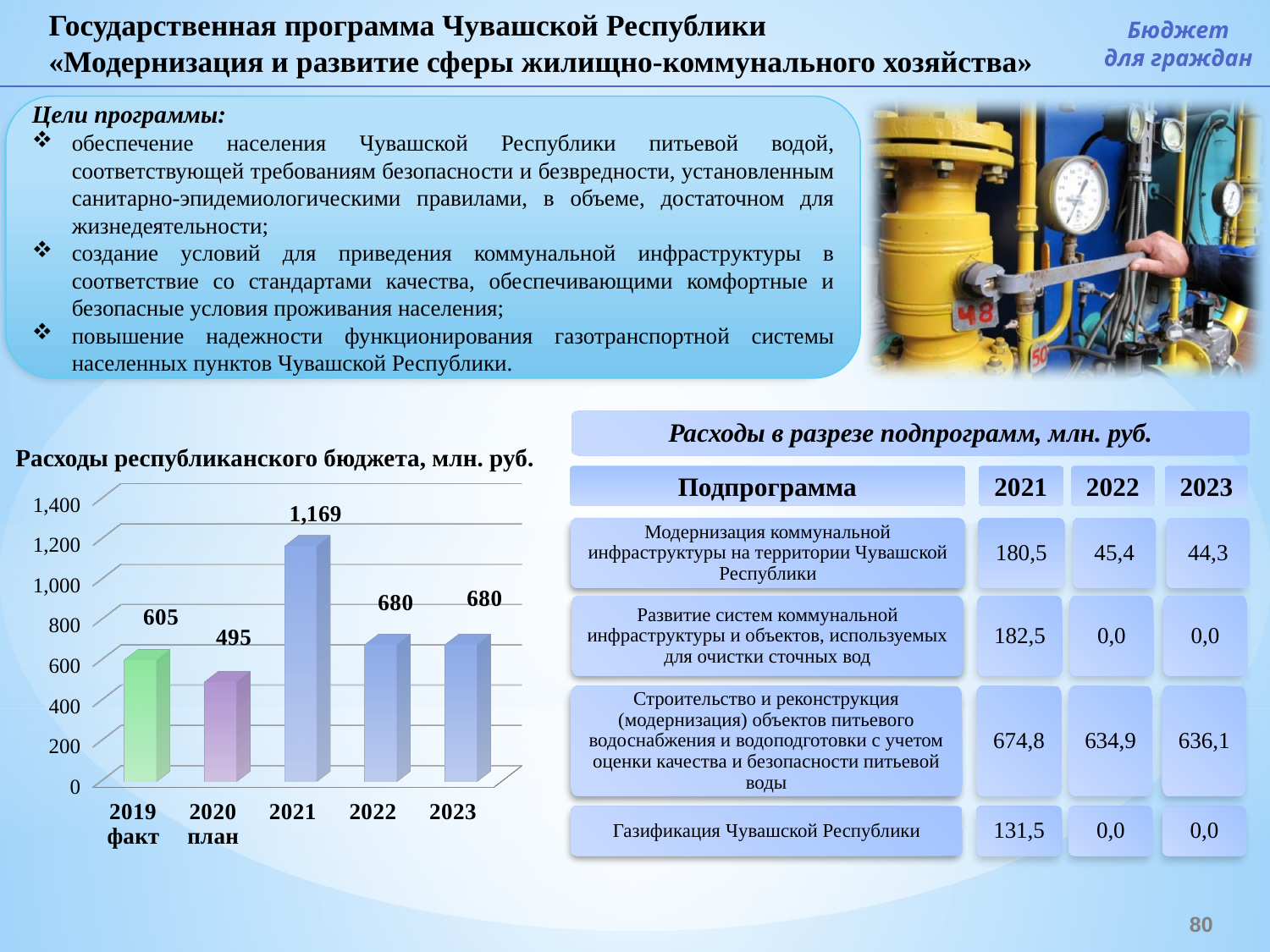
Which year has the highest value in the chart "Расходы республиканского бюджета, млн. руб."? 2021 What is the difference between the values for 2021 and 2022 in the chart "Расходы республиканского бюджета, млн. руб."? 489 What is the difference between the values for 2019 факт and 2020 план in the chart "Расходы республиканского бюджета, млн. руб."? 110 What kind of chart is "Расходы республиканского бюджета, млн. руб."? bar chart How many bars are shown in the chart "Расходы республиканского бюджета, млн. руб."? 5 Which year has the lowest value in the chart "Расходы республиканского бюджета, млн. руб."? 2020 план What is the value for 2019 факт in the chart "Расходы республиканского бюджета, млн. руб."? 605 What is the value for 2020 план in the chart "Расходы республиканского бюджета, млн. руб."? 495 Which is larger in the chart "Расходы республиканского бюджета, млн. руб.": the value for 2019 факт or the value for 2022? 2022 What is the value for 2021 in the chart "Расходы республиканского бюджета, млн. руб."? 1,169 Is the value for 2021 in the chart "Расходы республиканского бюджета, млн. руб." greater or less than 1,000? greater What is the value for 2023 in the chart "Расходы республиканского бюджета, млн. руб."? 680